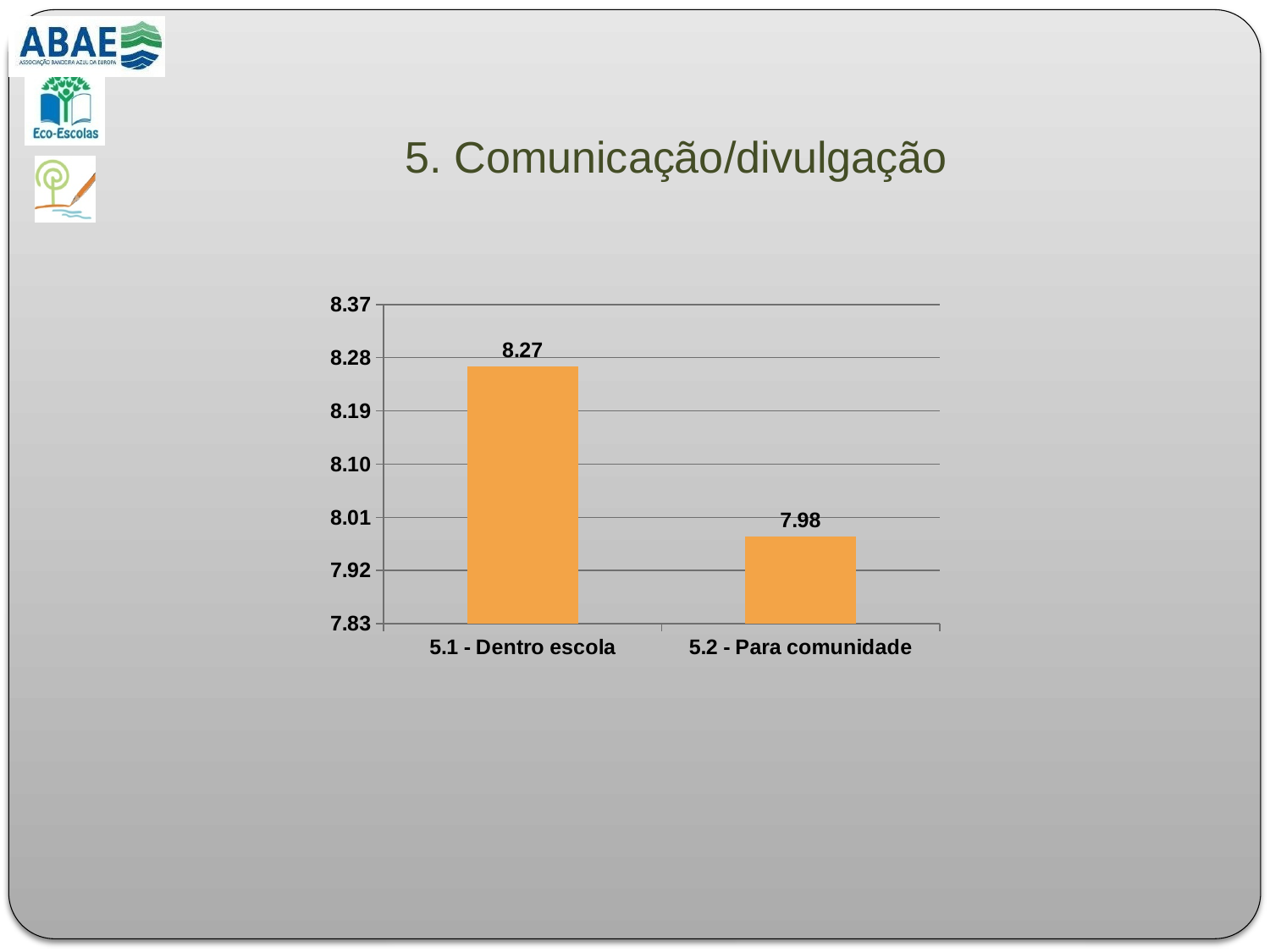
What is the difference between the values for 5.1 - Dentro escola and 5.2 - Para comunidade? 0.29 Is the value for 5.2 - Para comunidade greater or less than 8.10? less Which is larger, the value for 5.1 - Dentro escola or 5.2 - Para comunidade? 5.1 - Dentro escola How many categories are shown in the chart? 2 What is the value for 5.1 - Dentro escola? 8.27 What is the value for 5.2 - Para comunidade? 7.98 Which category has the lowest value? 5.2 - Para comunidade Do the values rise or fall from left to right along the x axis? fall What is the title of the slide containing the chart? 5. Comunicação/divulgação Is the value for 5.1 - Dentro escola greater or less than 8.19? greater What kind of chart is shown on the slide? bar chart Which category has the highest value? 5.1 - Dentro escola